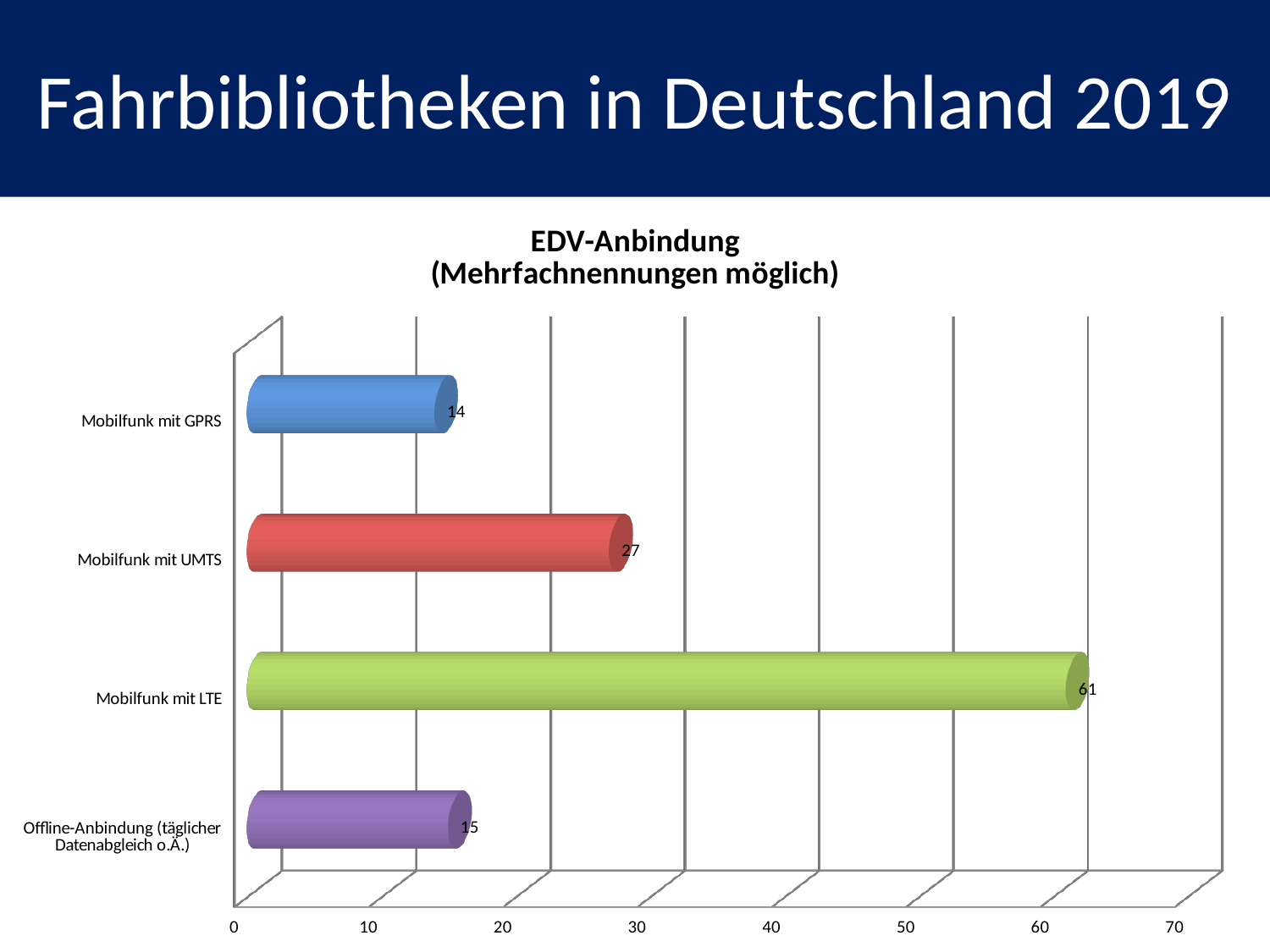
Which category has the lowest value? Mobilfunk mit GPRS What is the title of the chart? EDV-Anbindung (Mehrfachnennungen möglich) Which category has the highest value? Mobilfunk mit LTE How many categories are shown in the chart? 4 What is the value for Mobilfunk mit UMTS? 27 What is the value for Mobilfunk mit LTE? 61 What is the difference between the values for Mobilfunk mit LTE and Mobilfunk mit UMTS? 34 Which is larger, the value for Mobilfunk mit UMTS or the value for Offline-Anbindung (täglicher Datenabgleich o.Ä.)? Mobilfunk mit UMTS What kind of chart is shown on the slide? bar chart What is the value for Mobilfunk mit GPRS? 14 Is the value for Mobilfunk mit LTE greater or less than 50? greater What is the value for Offline-Anbindung (täglicher Datenabgleich o.Ä.)? 15